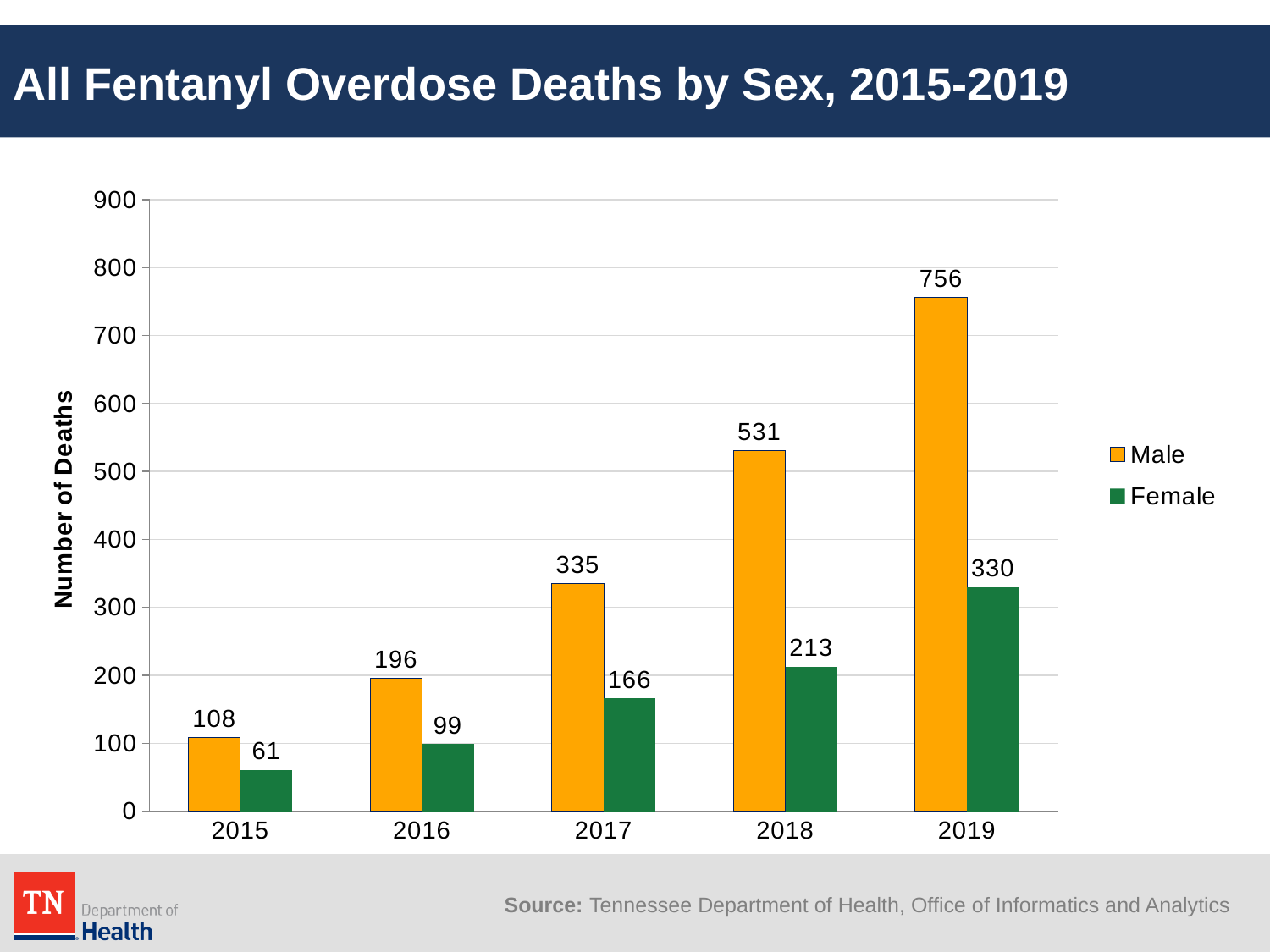
How many years are shown on the x axis? 5 What is the number of Male fentanyl overdose deaths in 2019? 756 How many series does the legend list? 2 Do Male deaths rise or fall from 2015 to 2019? Rise Which is larger, Male deaths in 2016 or Female deaths in 2019? Female deaths in 2019 What is the label of the y axis? Number of Deaths What is the number of Female fentanyl overdose deaths in 2017? 166 What kind of chart is shown on the slide? Bar chart What is the difference between Male and Female deaths in 2018? 318 Which year has the highest number of Female deaths? 2019 Which year has the lowest number of Male deaths? 2015 What is the number of Male fentanyl overdose deaths in 2015? 108